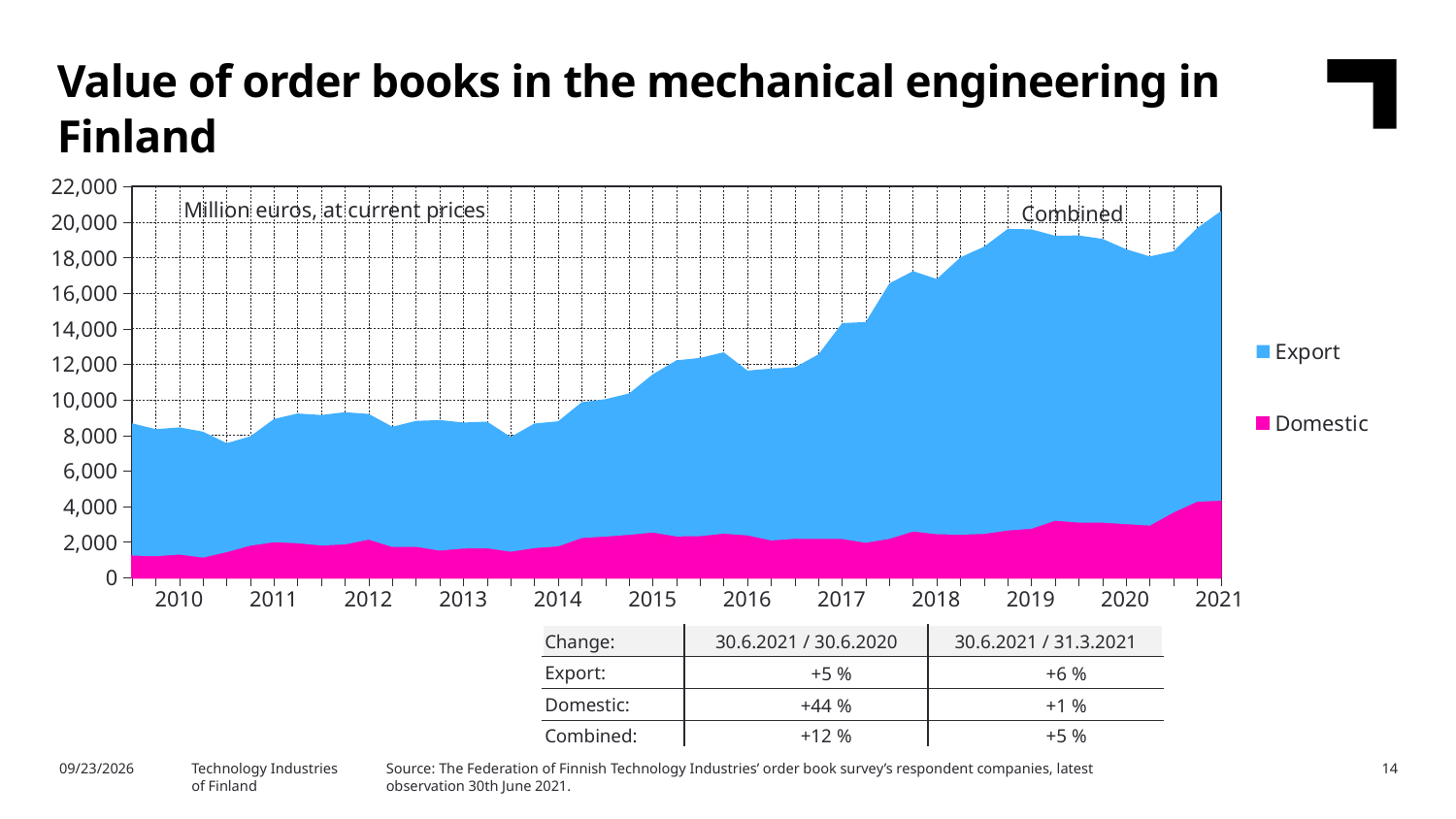
How many years are labelled on the x axis? 12 What kind of chart is shown on the slide? Area chart Is the combined value of order books in 2019 greater or less than 18,000? greater How many series does the legend list? 2 Is the combined value of order books in 2018 greater or less than 16,000? greater What are the two series named in the legend? Export and Domestic Is the Domestic value at the start of 2010 greater or less than 2,000? less Does the combined value of order books generally rise or fall from 2010 to 2021? rise In 2021, which series is larger, Export or Domestic? Export What unit is stated in the label inside the chart area? Million euros, at current prices In which year does the combined value of order books reach its highest point? 2021